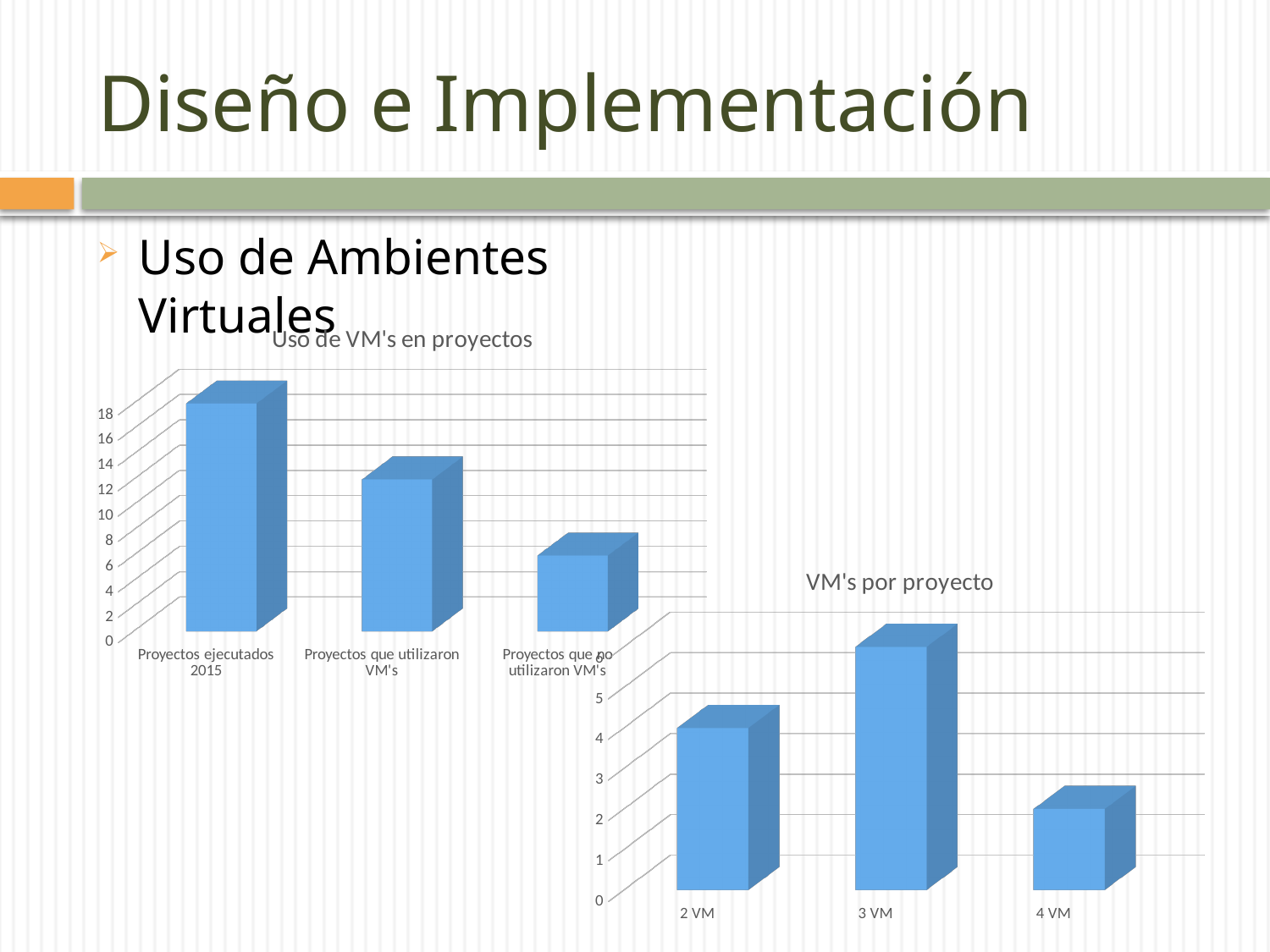
What type of chart is 'VM's por proyecto'? bar chart In the 'VM's por proyecto' chart, is the value for '4 VM' greater or less than 3? less How many categories does the 'Uso de VM's en proyectos' chart show? 3 In the 'Uso de VM's en proyectos' chart, which category has the highest value? Proyectos ejecutados 2015 How many categories does the 'VM's por proyecto' chart show? 3 In the 'VM's por proyecto' chart, which category has the highest value? 3 VM What type of chart is 'Uso de VM's en proyectos'? bar chart In the 'VM's por proyecto' chart, which is larger: the value for '2 VM' or '4 VM'? 2 VM In the 'Uso de VM's en proyectos' chart, which category has the lowest value? Proyectos que no utilizaron VM's In the 'Uso de VM's en proyectos' chart, is the value for 'Proyectos que no utilizaron VM's' greater or less than 8? less In the 'Uso de VM's en proyectos' chart, do the values rise or fall from left to right? fall In the 'Uso de VM's en proyectos' chart, is the value for 'Proyectos que utilizaron VM's' greater or less than 10? greater